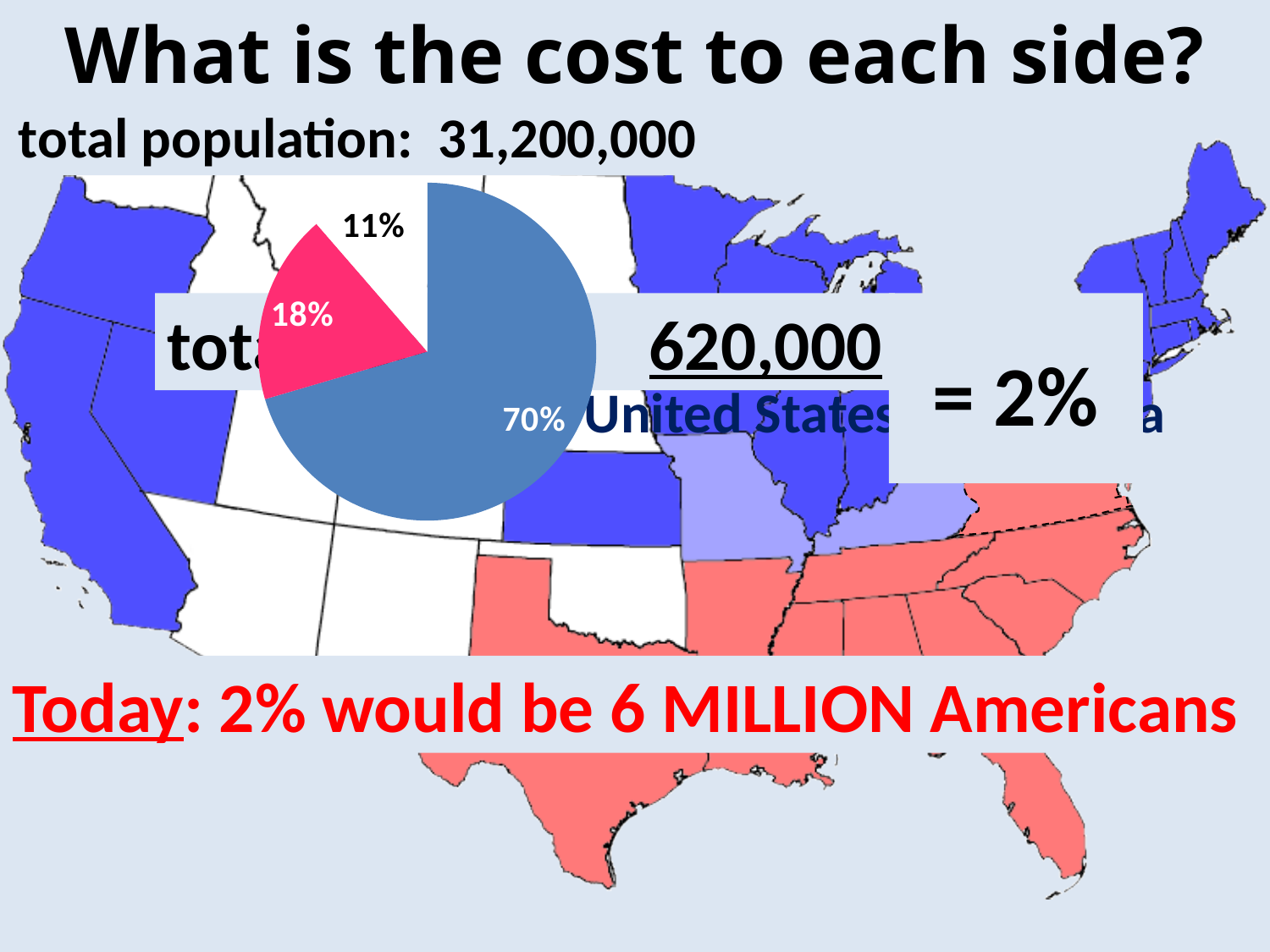
What percentage is labelled on the largest (blue) slice of the pie chart? 70% By how many percentage points does the 18% slice exceed the 11% slice? 7 What colour is the slice labelled 18%? pink How many slices does the pie chart have? 3 What colour is the largest slice of the pie chart? blue What kind of chart is shown on the slide? pie chart Which slice of the pie chart is larger, the pink one or the white one? the pink one What is the smallest percentage shown in the pie chart? 11% What percentage is labelled on the white slice of the pie chart? 11% What is the largest percentage shown in the pie chart? 70% By how many percentage points does the 70% slice exceed the 18% slice? 52 What percentage is labelled on the pink slice of the pie chart? 18%